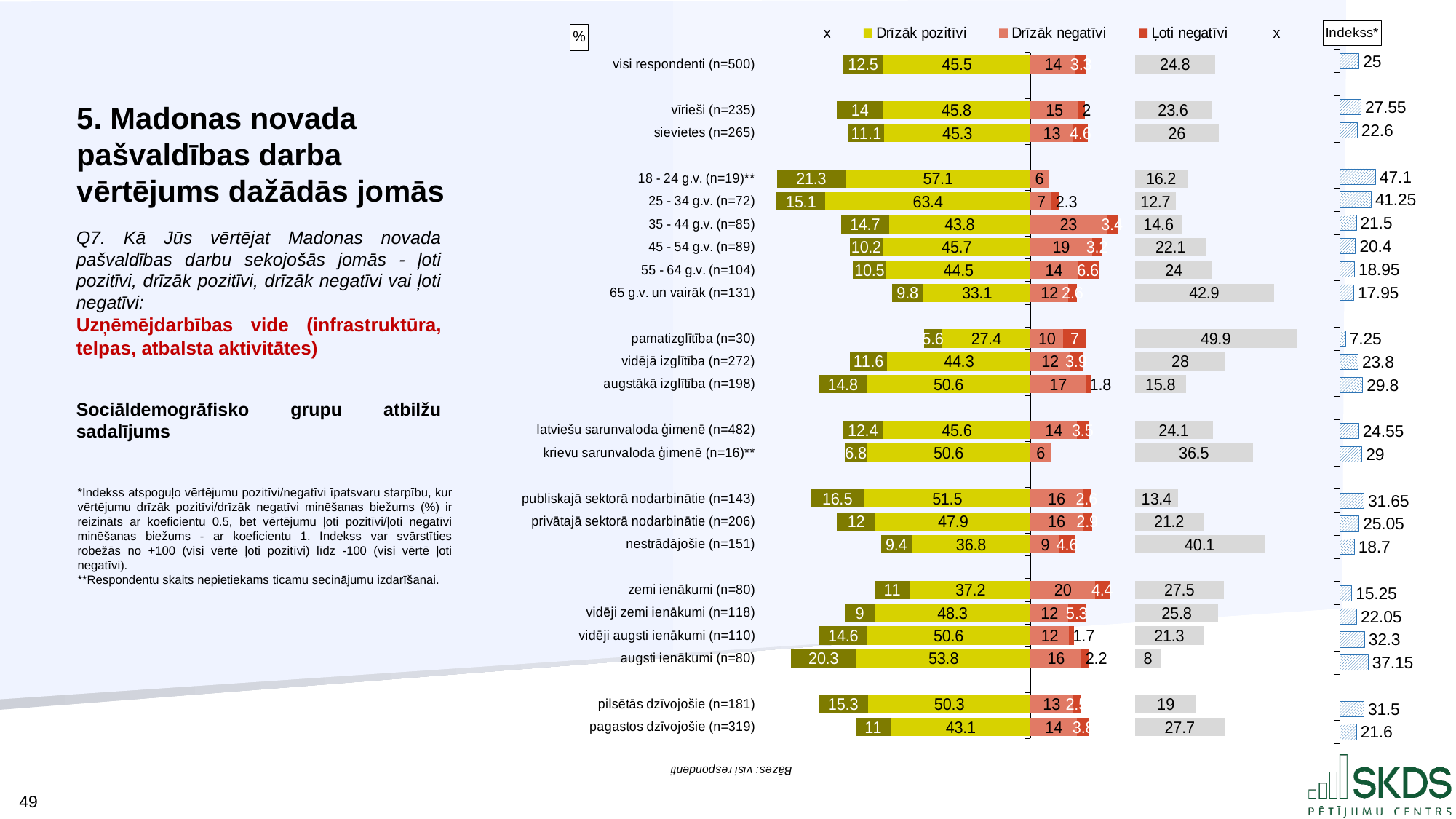
What is the Indekss value for the 18 - 24 g.v. (n=19)** group? 47.1 What kind of chart is shown on the slide? Stacked bar chart What is the 'Drīzāk pozitīvi' value for the 25 - 34 g.v. (n=72) group? 63.4 Which group has the larger 'Drīzāk pozitīvi' value: augsti ienākumi (n=80) or zemi ienākumi (n=80)? augsti ienākumi (n=80) Which group has the lowest Indekss value? pamatizglītība (n=30) What is the 'Drīzāk negatīvi' value for the 35 - 44 g.v. (n=85) group? 23 What is the difference between the Indekss values for vīrieši (n=235) and sievietes (n=265)? 4.95 What is the difference between the 'Drīzāk pozitīvi' values for pilsētās dzīvojošie (n=181) and pagastos dzīvojošie (n=319)? 7.2 Which group has the highest 'Drīzāk pozitīvi' value? 25 - 34 g.v. (n=72) Which group has the highest Indekss value? 18 - 24 g.v. (n=19)** How many named series does the legend list? 3 How many respondent groups are plotted in the chart? 23